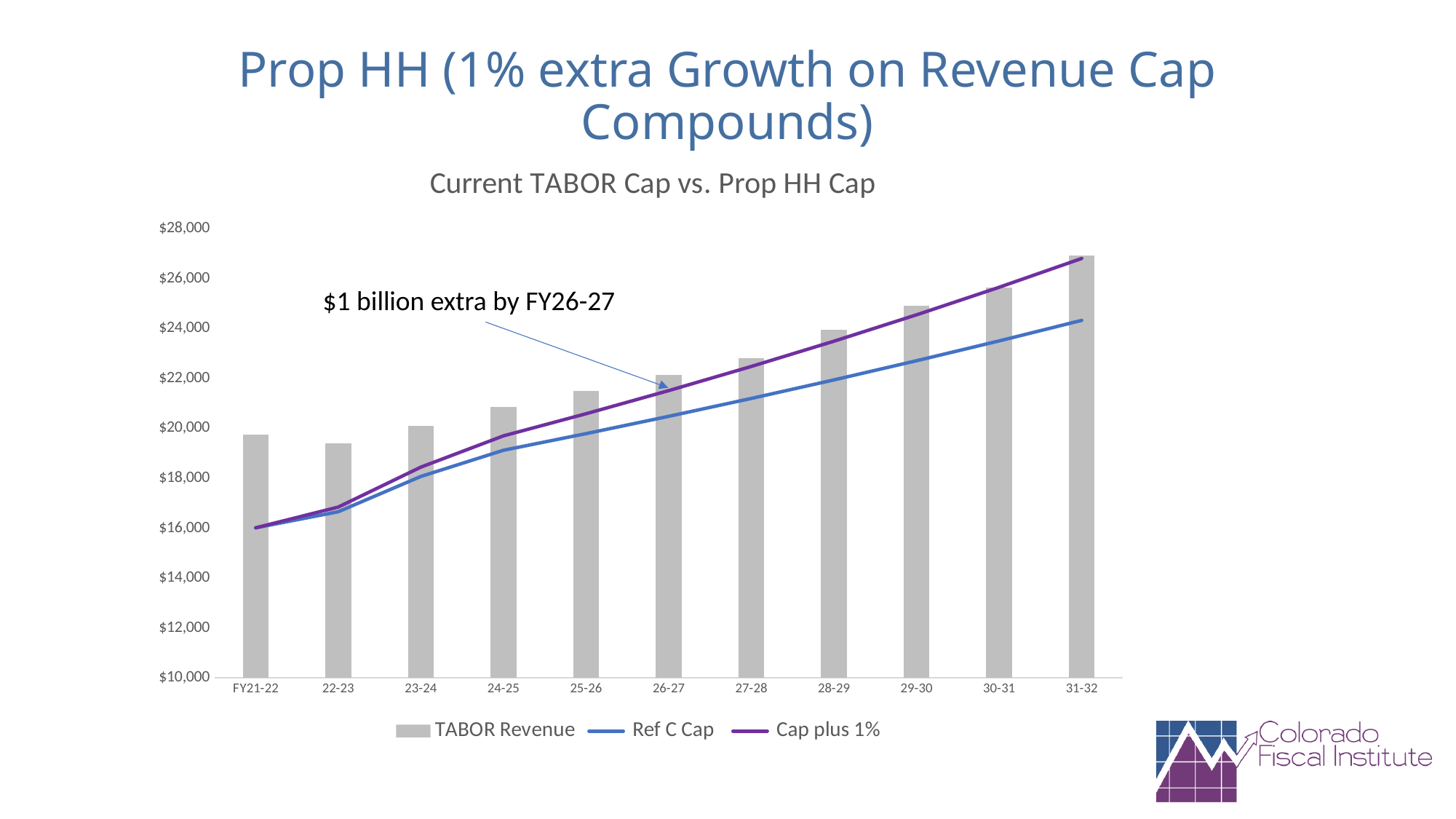
Is the Ref C Cap value for 31-32 greater or less than $26,000? less What kind of chart is shown on the slide? A combined bar and line chart How many series does the chart's legend list? 3 In 31-32, which is larger: Cap plus 1% or Ref C Cap? Cap plus 1% Does the Cap plus 1% line rise or fall from FY21-22 to 31-32? rise Is the TABOR Revenue value for 22-23 greater or less than $20,000? less Is the TABOR Revenue value for 31-32 greater or less than $26,000? greater How many fiscal years are shown along the x axis of the chart? 11 What is the title of the chart on the slide? Current TABOR Cap vs. Prop HH Cap What does the annotation with the arrow pointing at the 26-27 bar say? $1 billion extra by FY26-27 In which fiscal year is TABOR Revenue highest? 31-32